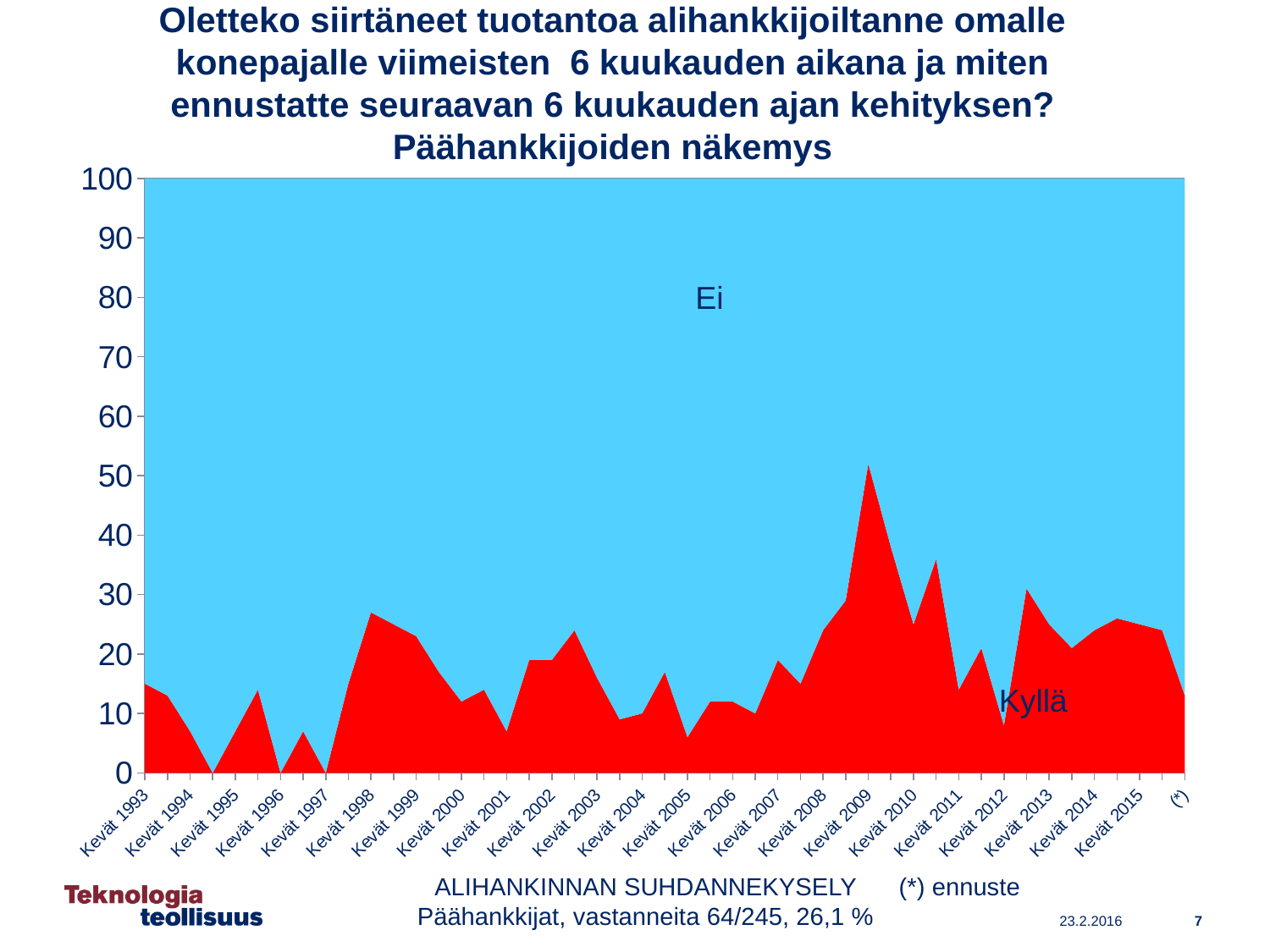
Is the Kyllä value at Kevät 2013 greater or less than 20? greater Which series is shown in blue? Ei At which labeled survey does the Kyllä series reach its highest value? Kevät 2009 Which series is shown in red? Kyllä Is the Kyllä value at Kevät 2012 greater or less than 10? less Is the Kyllä value at Kevät 1998 greater or less than 20? greater How many series are shown in the chart? 2 Which has a larger Kyllä value, Kevät 2009 or Kevät 2011? Kevät 2009 What kind of chart is shown on the slide? Area chart Which has a larger Kyllä value, Kevät 1998 or Kevät 2005? Kevät 1998